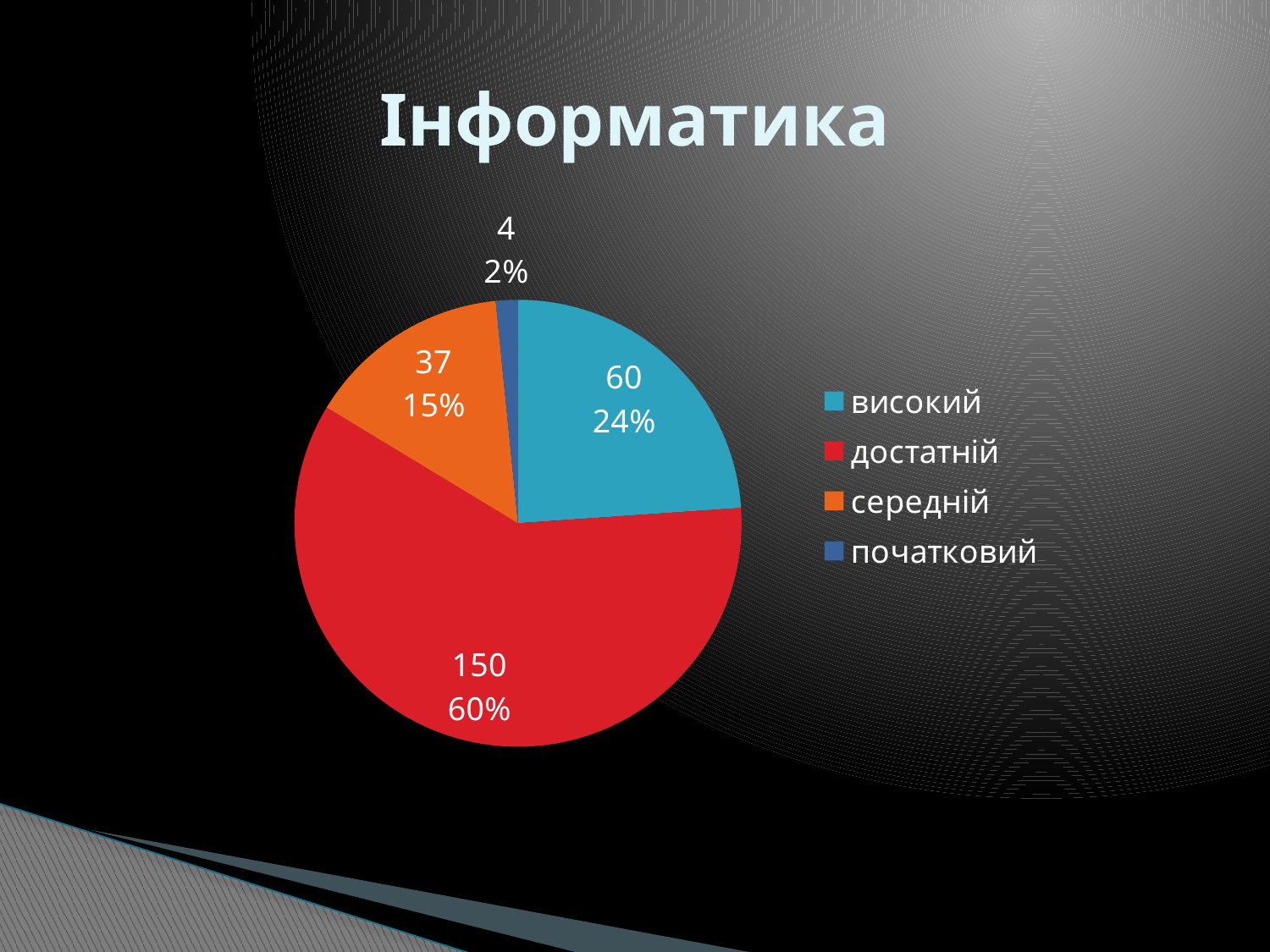
Which is larger, the value for високий or the value for середній? високий What kind of chart is shown on the slide? pie chart What is the value for початковий? 4 What is the value for достатній? 150 Which category has the largest slice? достатній What is the difference between the values for достатній and високий? 90 How many categories does the legend list? 4 Which category has the smallest slice? початковий What share of the pie does достатній take? 60% What share of the pie does середній take? 15% What is the value for високий? 60 What is the value for середній? 37